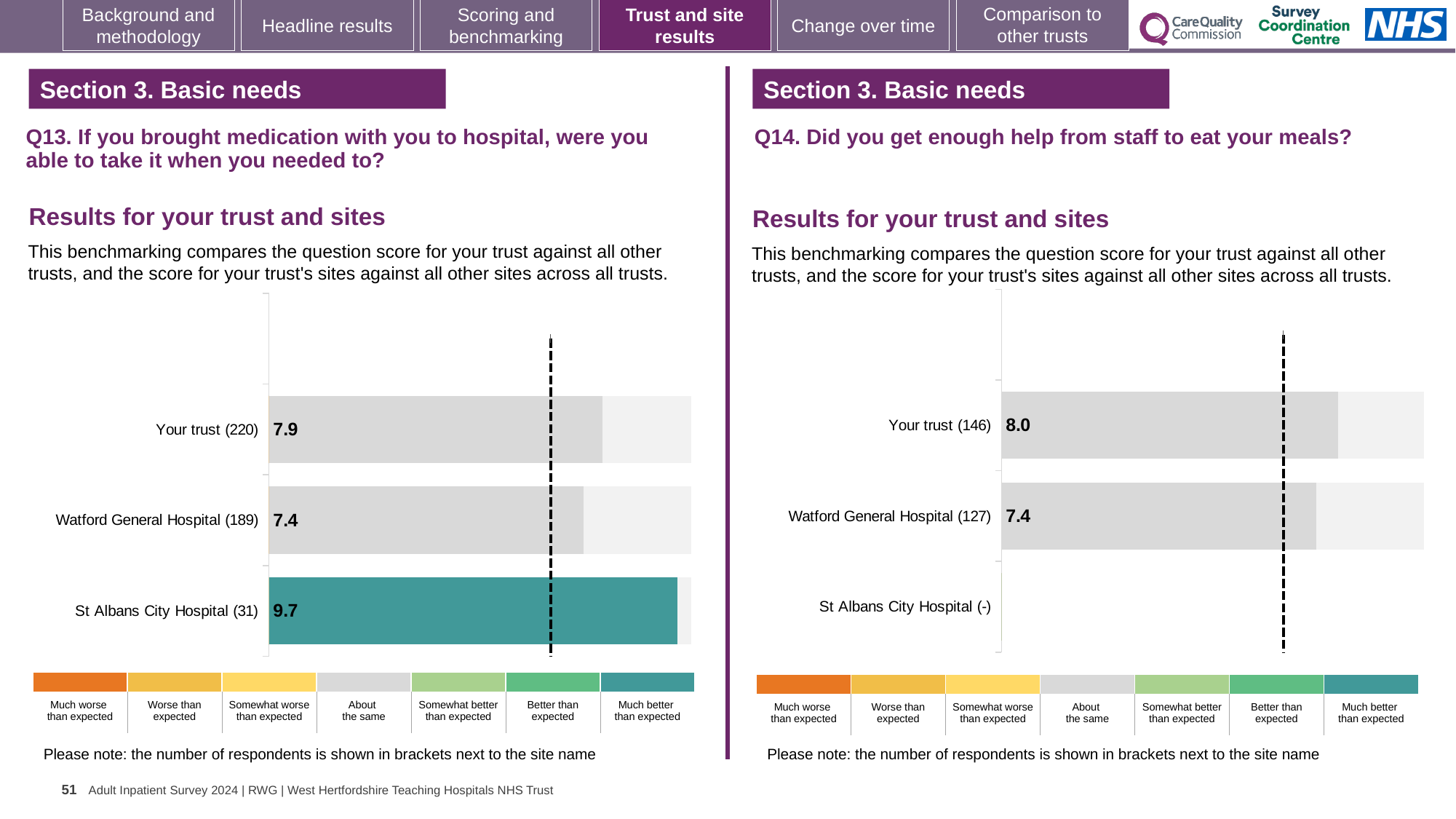
In the Q14 chart on the right, how many respondents are shown for Your trust? 146 In the Q13 chart on the left, what is the score for St Albans City Hospital? 9.7 In the Q13 chart on the left, which benchmark category does the St Albans City Hospital bar colour correspond to? Much better than expected In the Q13 chart on the left, what is the score for Watford General Hospital? 7.4 In the Q13 chart on the left, what is the difference between the St Albans City Hospital score and the Watford General Hospital score? 2.3 In the Q14 chart on the right, what is the score for Your trust? 8.0 What type of chart is used in the Q13 chart on the left? Bar chart In the Q14 chart on the right, which is larger, the score for Your trust or the score for Watford General Hospital? Your trust In the Q13 chart on the left, which site or trust has the lowest score? Watford General Hospital In the Q13 chart on the left, what is the score for Your trust? 7.9 In the Q14 chart on the right, what is the score for Watford General Hospital? 7.4 In the Q13 chart on the left, which site or trust has the highest score? St Albans City Hospital